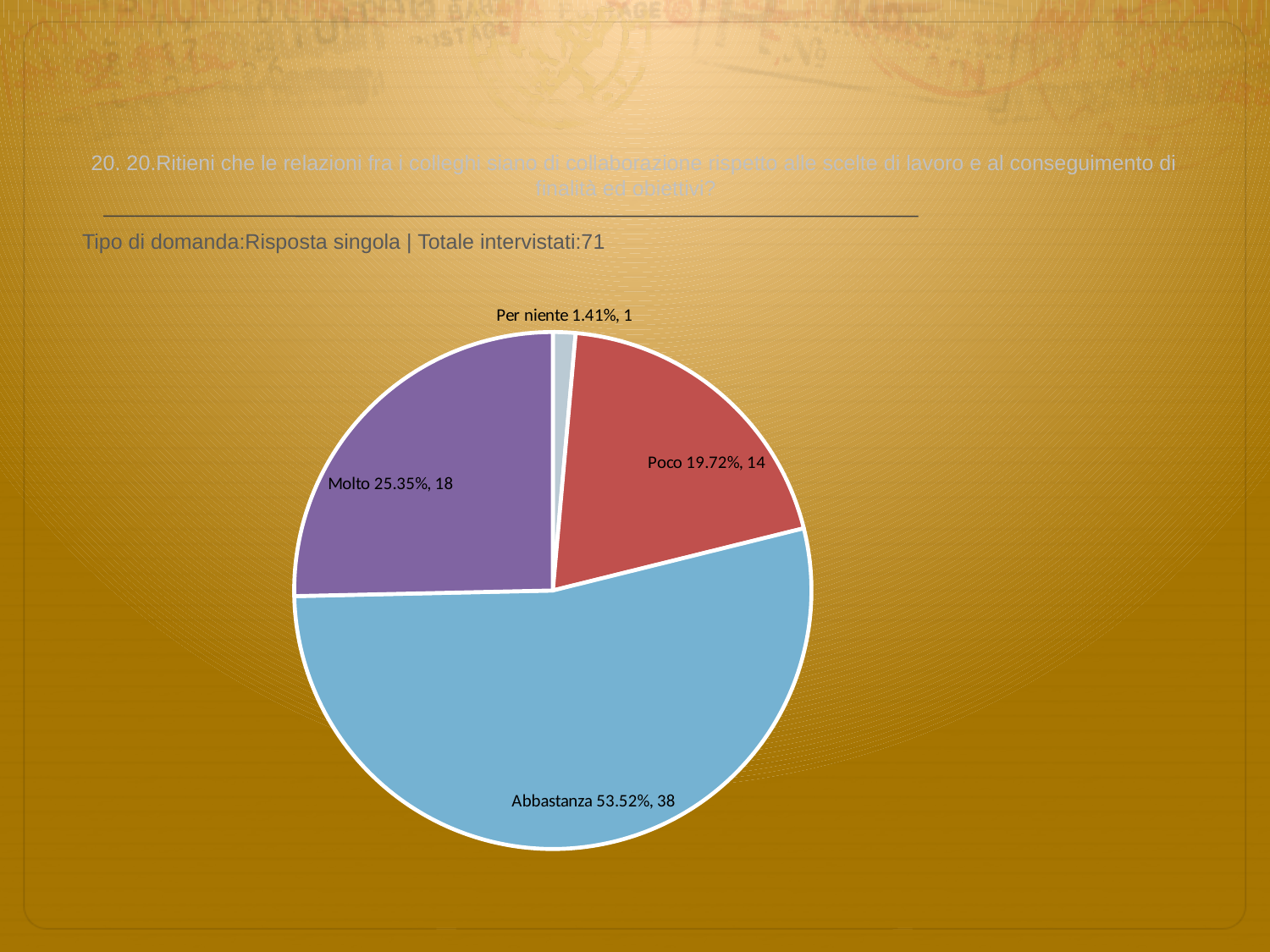
What is the total number of respondents across all slices? 71 How many respondents answered Poco? 14 Which category has the largest slice? Abbastanza What kind of chart is shown on the slide? pie chart What percentage share does the Per niente slice have? 1.41% What colour is the Abbastanza slice? light blue How many slices does the pie chart have? 4 What is the difference in respondent count between Abbastanza and Molto? 20 What percentage share does the Abbastanza slice have? 53.52% How many respondents answered Molto? 18 Which has more respondents, Molto or Poco? Molto Which category has the smallest slice? Per niente